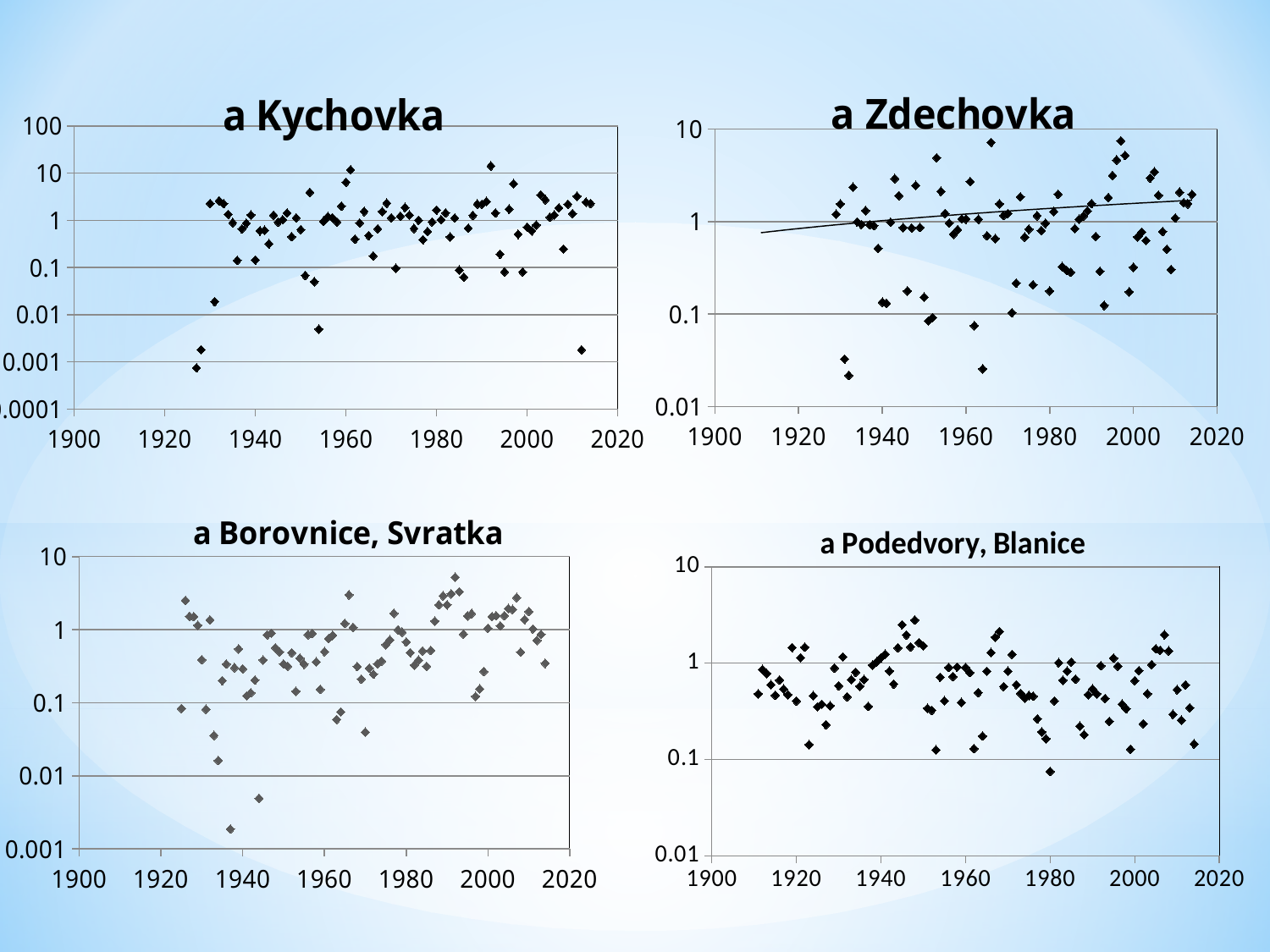
What is the lowest value shown on the y axis of the a Kychovka chart? 0.0001 In the a Zdechovka chart, does the trend line rise or fall from 1900 to 2020? rises In the a Borovnice, Svratka chart, is the lowest plotted point greater or less than 0.01? less What is the last year shown on the x axis of the a Borovnice, Svratka chart? 2020 What is the first year shown on the x axis of the a Podedvory, Blanice chart? 1900 What is the highest value shown on the y axis of the a Kychovka chart? 100 What kind of chart is the a Kychovka chart? scatter chart What is the title of the chart in the top-right position of the slide? a Zdechovka Which chart on the slide includes a fitted trend line? a Zdechovka In the a Kychovka chart, is the highest plotted point greater or less than 10? greater How many charts are shown on the slide? 4 In the a Zdechovka chart, is the highest plotted point greater or less than 10? less